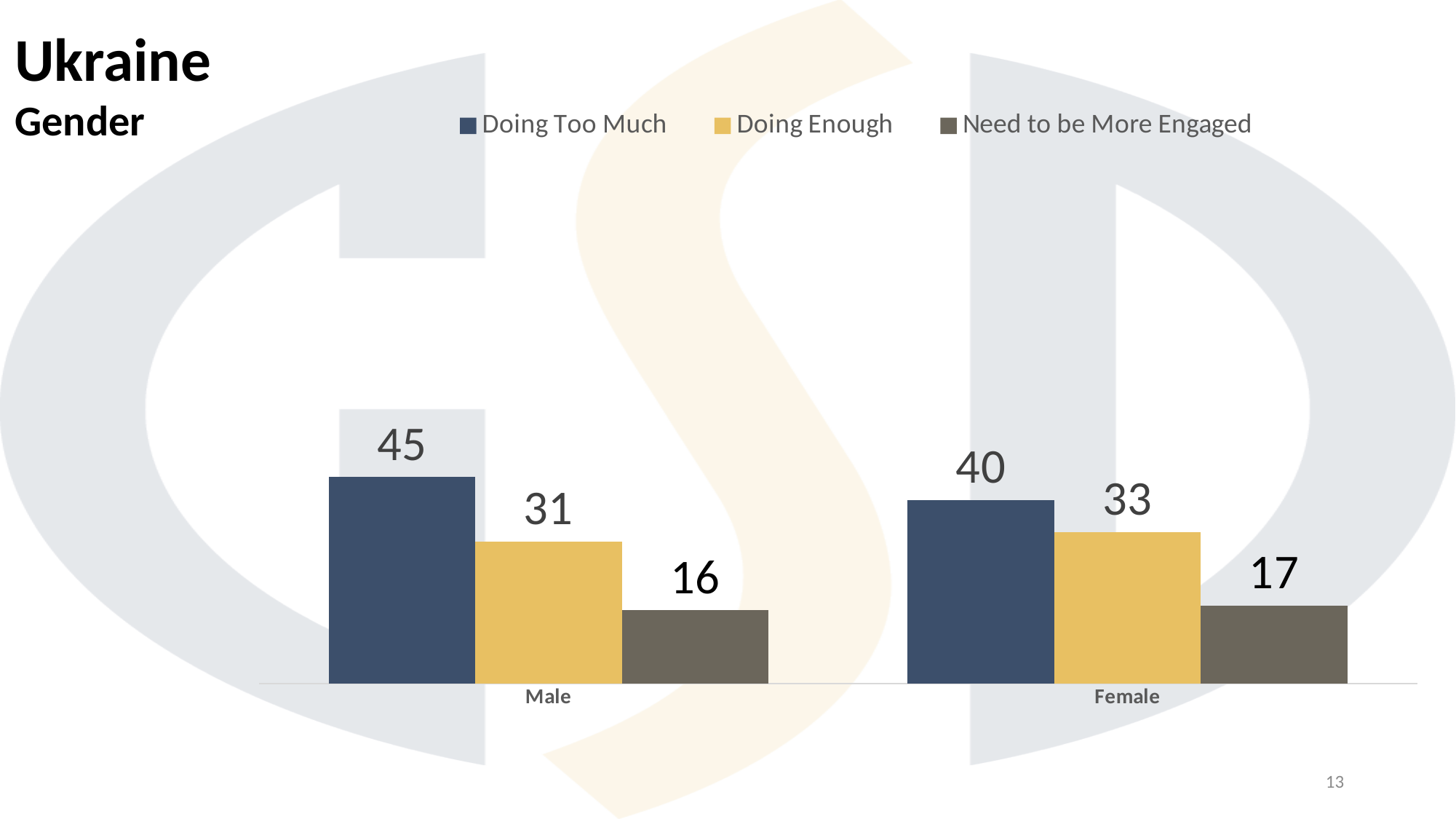
What is the value for "Need to be More Engaged" among Male respondents? 16 What kind of chart is shown on the slide? Bar chart Which series has the highest value for Female respondents? Doing Too Much Which series has the lowest value for Male respondents? Need to be More Engaged How many series does the legend list? 3 What is the value for "Doing Enough" among Female respondents? 33 What is the difference between the "Doing Too Much" values for Male and Female respondents? 5 Which colour represents the "Doing Enough" series in the legend? Yellow How many categories are shown on the x axis? 2 Which is larger: "Doing Enough" for Male or "Doing Enough" for Female? Female What is the difference between "Doing Too Much" and "Need to be More Engaged" for Female respondents? 23 What is the value for "Doing Too Much" among Male respondents? 45